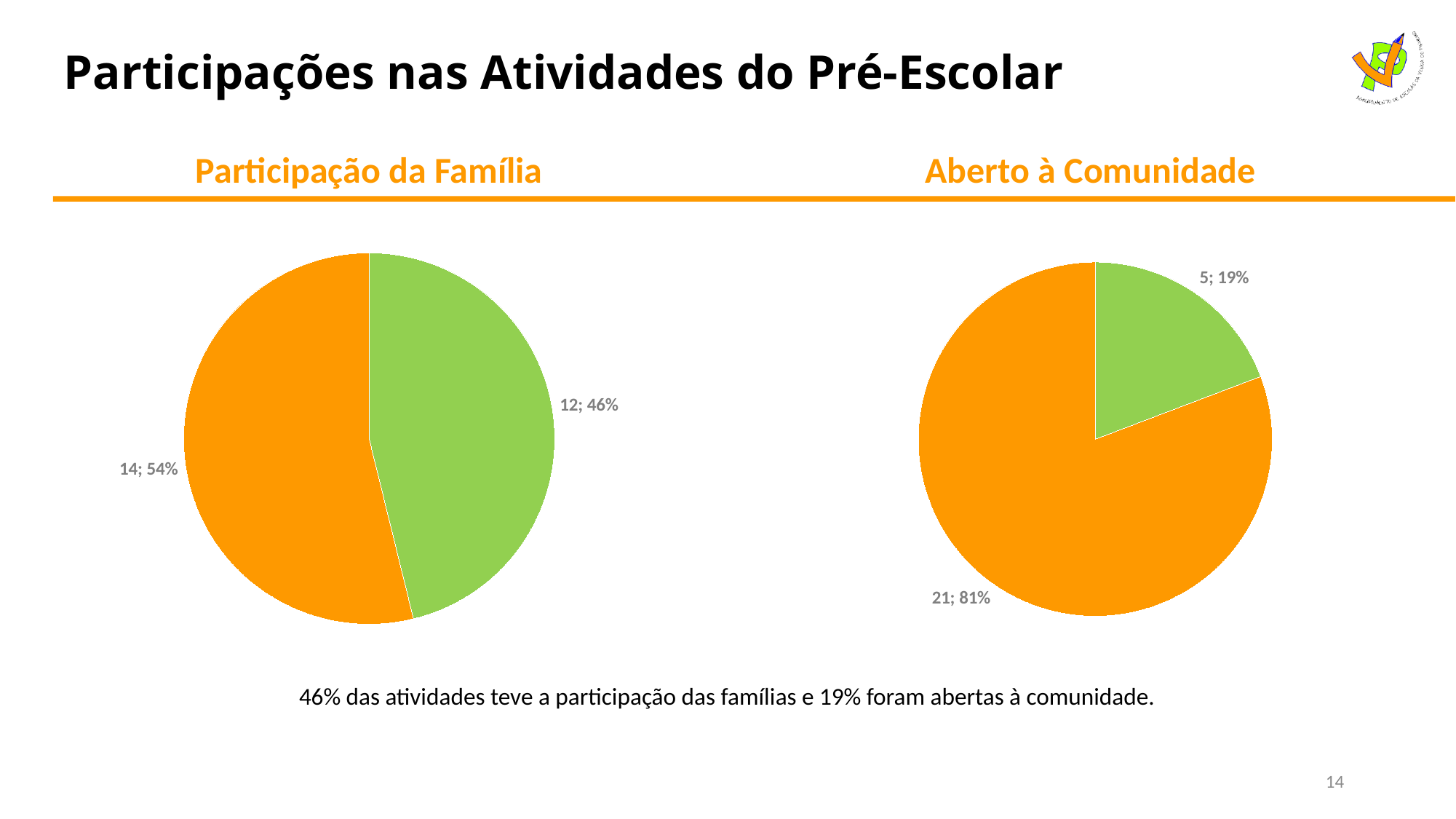
In the "Aberto à Comunidade" chart, what share of the pie does the orange slice represent? 81% In the "Aberto à Comunidade" chart, what is the difference between the orange slice value and the green slice value? 16 How many slices does the "Aberto à Comunidade" pie chart have? 2 What kind of chart is the "Participação da Família" chart? Pie chart In the "Aberto à Comunidade" chart, which slice is the largest? The orange slice (21; 81%) In the "Aberto à Comunidade" chart, what value is shown for the green slice? 5 In the "Participação da Família" chart, what value is shown for the orange slice? 14 Which is larger: the green slice in the "Participação da Família" chart or the green slice in the "Aberto à Comunidade" chart? The green slice in "Participação da Família" (12) In the "Participação da Família" chart, what is the total of the two slice values? 26 What is the title of the pie chart on the right side of the slide? Aberto à Comunidade In the "Participação da Família" chart, what value is shown for the green slice? 12 In the "Participação da Família" chart, what share of the pie does the green slice represent? 46%